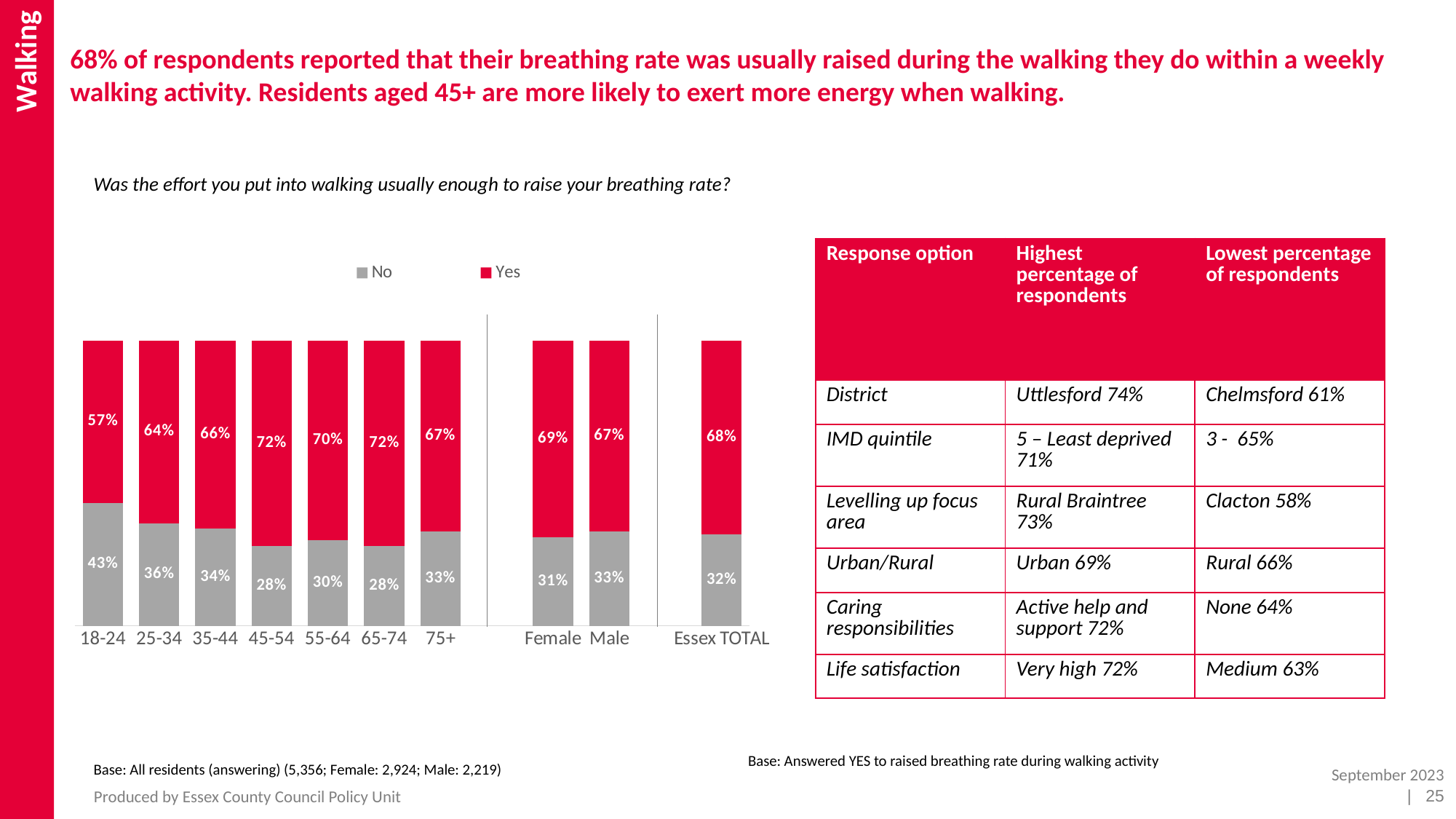
Which age group has the lowest Yes percentage? 18-24 What percentage of respondents aged 18-24 answered Yes? 57% What is the Yes value for Essex TOTAL? 68% How many age group categories are shown on the x axis? 7 What is the difference between the Yes percentage for 25-34 and 18-24? 7% What type of chart is shown? Stacked bar chart What is the No value for Female respondents? 31% Which has a higher Yes percentage, Female or Male? Female Which colour represents the Yes series? Red What percentage of respondents aged 45-54 answered No? 28% How many series does the legend list? 2 Which age group has the highest Yes percentage? 45-54 and 65-74 (72%)